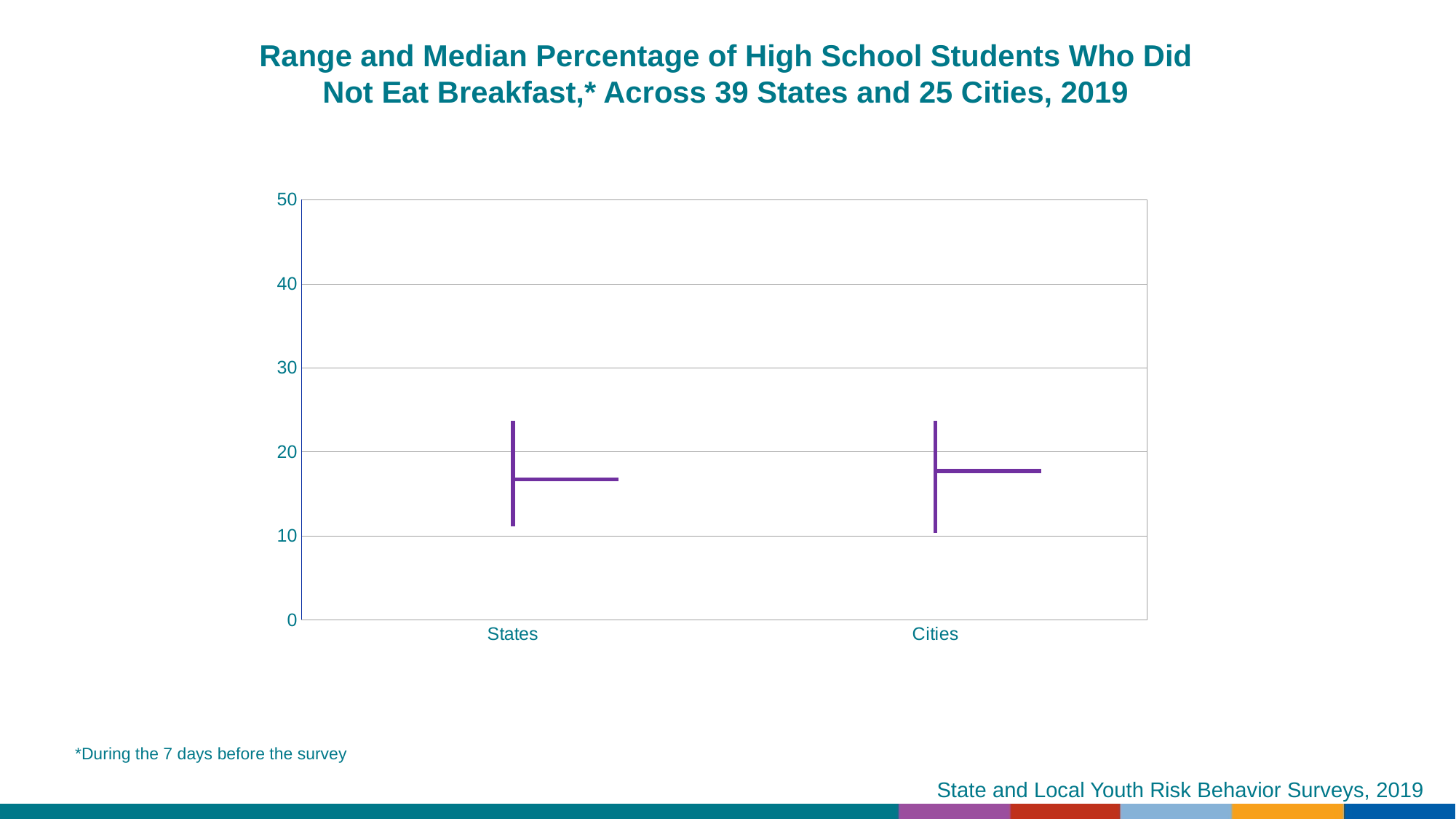
How many categories are shown on the x axis of the chart? 2 Is the median value for States greater or less than 10? greater Is the median value for Cities greater or less than 10? greater What are the two categories shown on the x axis? States and Cities What is the title of the chart? Range and Median Percentage of High School Students Who Did Not Eat Breakfast,* Across 39 States and 25 Cities, 2019 Is the bottom of the range for Cities greater or less than 20? less What is the highest value shown on the y axis of the chart? 50